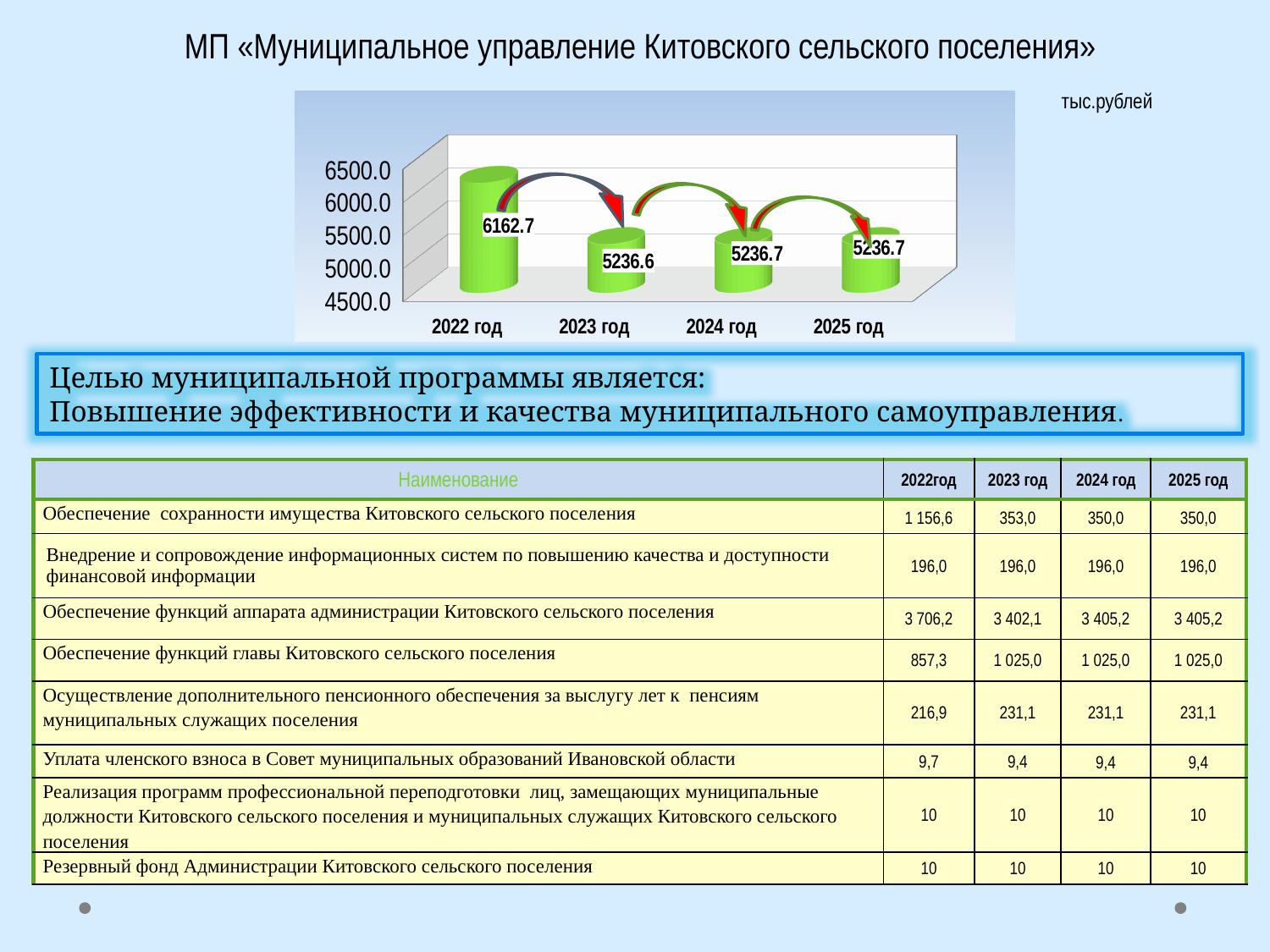
Which year has the highest value in the chart? 2022 год What is the value for 2022 год in the chart? 6162.7 What is the difference between the values for 2022 год and 2023 год? 926.1 What is the value for 2023 год in the chart? 5236.6 What is the value for 2025 год in the chart? 5236.7 Do the values rise or fall from 2022 год to 2023 год? fall How many years are shown on the x axis of the chart? 4 What kind of chart is shown on the slide? bar chart Is the value for 2022 год greater or less than 6000.0? greater Which is larger, the value for 2022 год or the value for 2024 год? 2022 год What is the value for 2024 год in the chart? 5236.7 Is the value for 2023 год greater or less than 5500.0? less